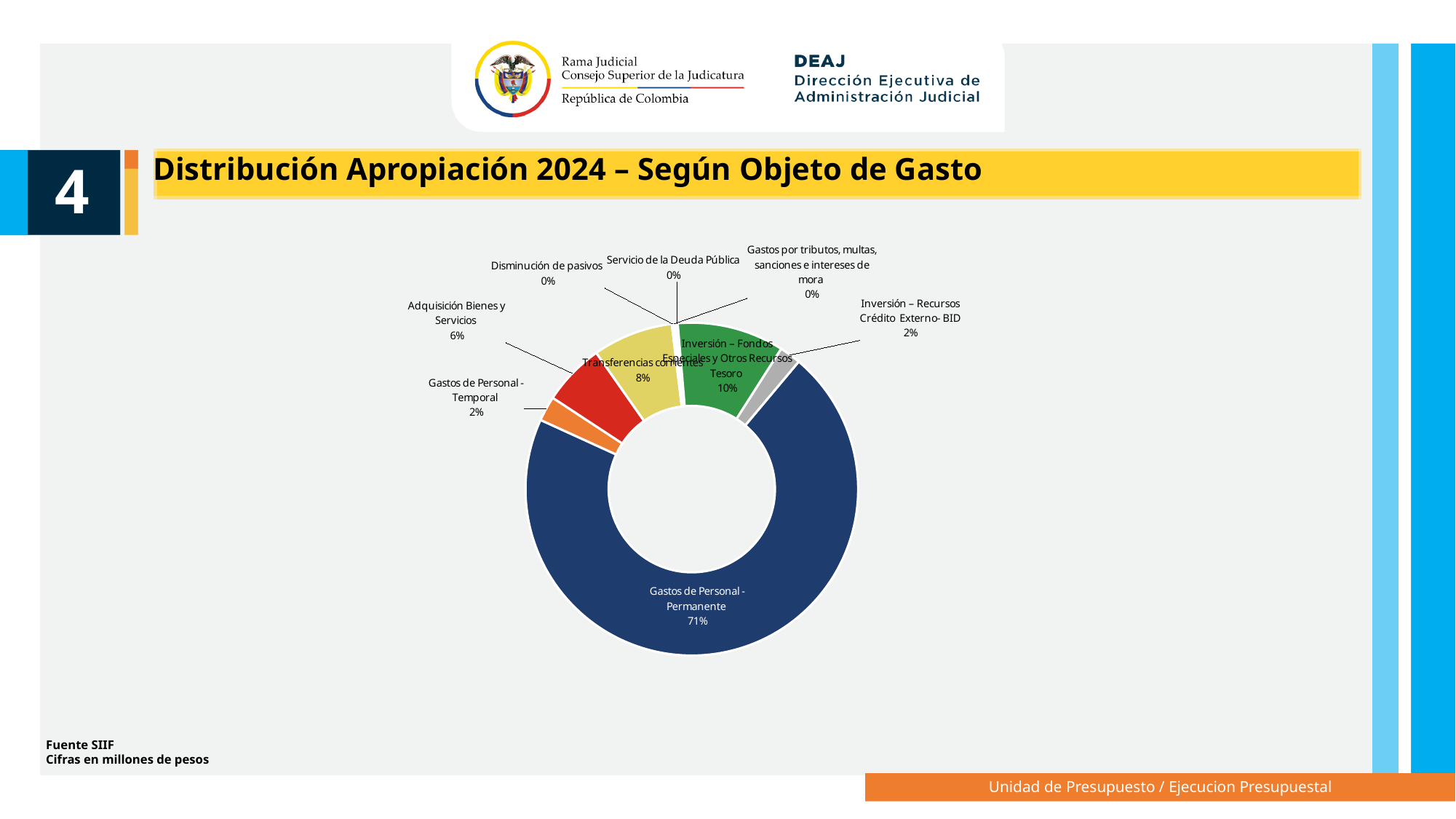
What percentage is shown for Gastos de Personal - Permanente? 71% Which is larger, Transferencias corrientes or Adquisición Bienes y Servicios? Transferencias corrientes What percentage is shown for Servicio de la Deuda Pública? 0% Which category has the largest share of the chart? Gastos de Personal - Permanente What percentage is shown for Inversión – Fondos Especiales y Otros Recursos Tesoro? 10% What percentage is shown for Adquisición Bienes y Servicios? 6% What is the difference in percentage points between Gastos de Personal - Permanente and Inversión – Fondos Especiales y Otros Recursos Tesoro? 61 percentage points What percentage is shown for Inversión – Recursos Crédito Externo- BID? 2% What is the title of the chart on the slide? Distribución Apropiación 2024 – Según Objeto de Gasto What kind of chart is shown on the slide? Doughnut (pie) chart How many categories are labelled on the chart? 9 What percentage is shown for Transferencias corrientes? 8%